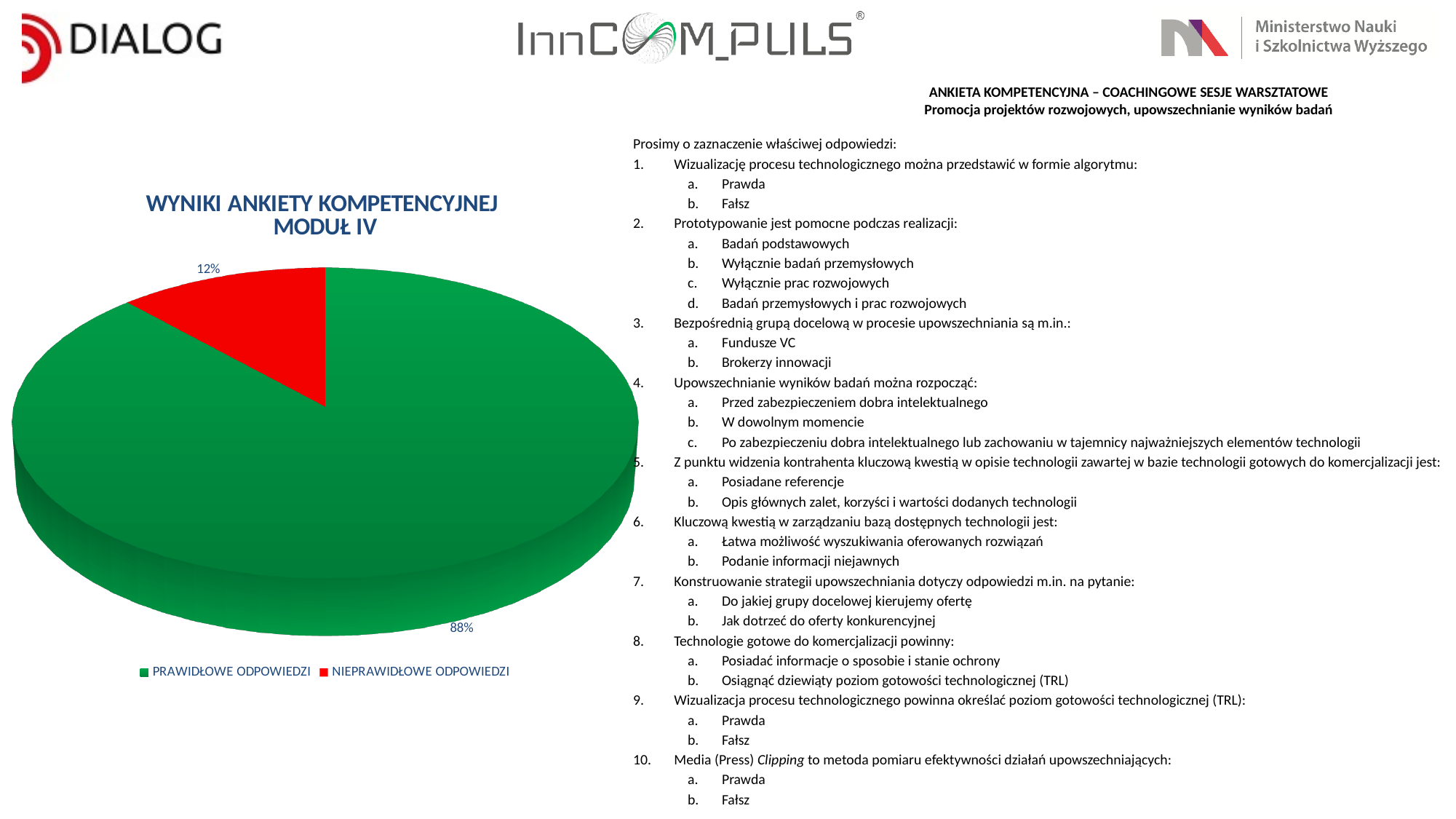
What share of the pie does NIEPRAWIDŁOWE ODPOWIEDZI represent? 12% What is the title of the chart? WYNIKI ANKIETY KOMPETENCYJNEJ MODUŁ IV Which is larger, the share for PRAWIDŁOWE ODPOWIEDZI or for NIEPRAWIDŁOWE ODPOWIEDZI? PRAWIDŁOWE ODPOWIEDZI Which category has the smallest slice of the pie? NIEPRAWIDŁOWE ODPOWIEDZI What colour is the slice for NIEPRAWIDŁOWE ODPOWIEDZI? Red Which category has the largest slice of the pie? PRAWIDŁOWE ODPOWIEDZI What share of the pie does PRAWIDŁOWE ODPOWIEDZI represent? 88% How many slices does the pie chart have? 2 How many entries does the legend list? 2 What kind of chart is shown on the slide? Pie chart What is the difference in percentage points between PRAWIDŁOWE ODPOWIEDZI and NIEPRAWIDŁOWE ODPOWIEDZI? 76